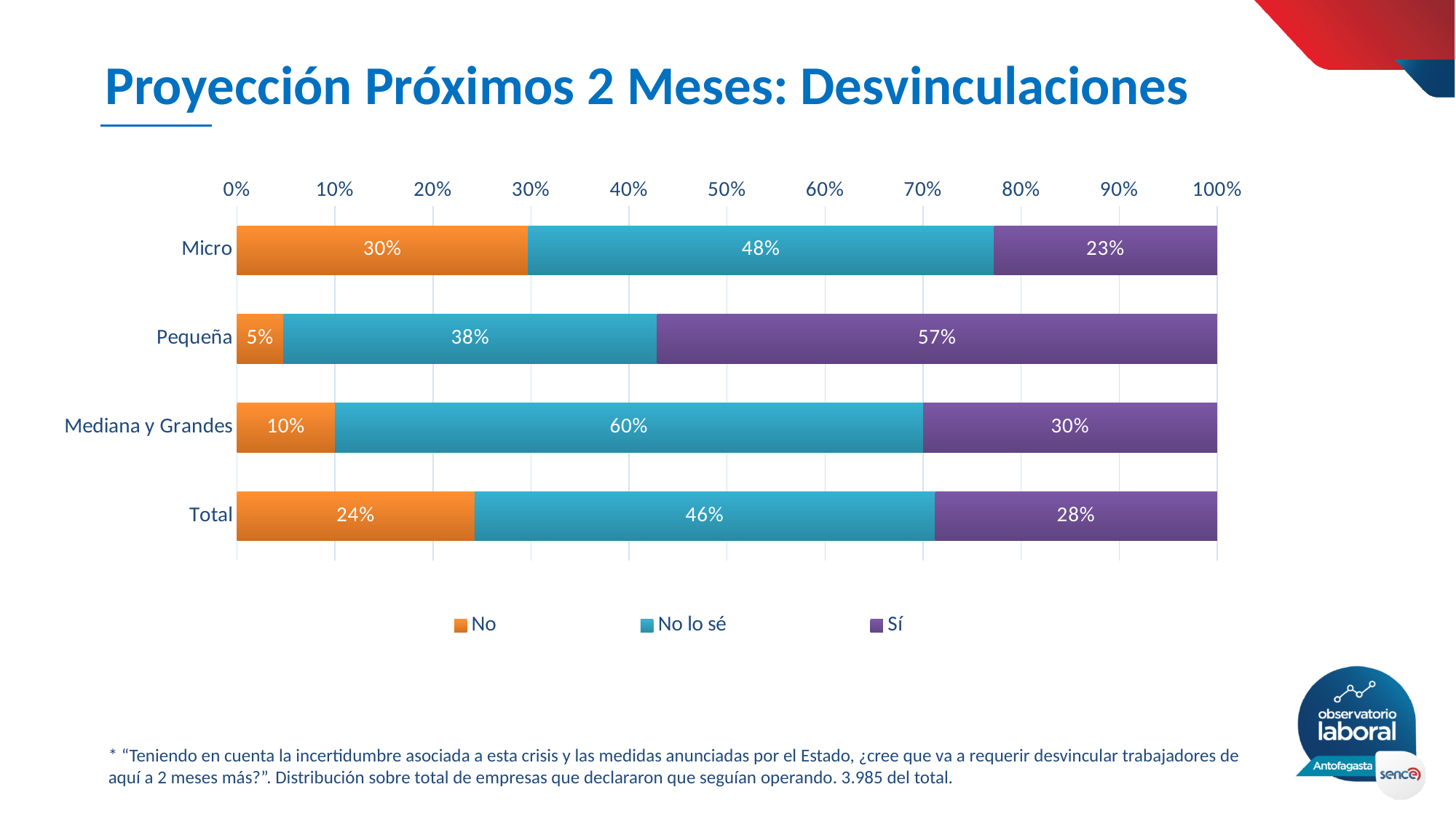
Which is larger: the "No" value for Micro or the "No" value for Mediana y Grandes? Micro Which series is shown in purple? Sí What is the value for "No lo sé" in the Mediana y Grandes category? 60% Which category has the highest value for "Sí"? Pequeña What is the value for "No" in the Total category? 24% How many series does the legend list? 3 Which category has the lowest value for "No"? Pequeña What kind of chart is shown on the slide? Stacked bar chart What is the title of the slide? Proyección Próximos 2 Meses: Desvinculaciones What is the difference between the "No lo sé" values for Mediana y Grandes and Pequeña? 22% How many categories are shown on the y axis? 4 What is the value for "Sí" in the Pequeña category? 57%